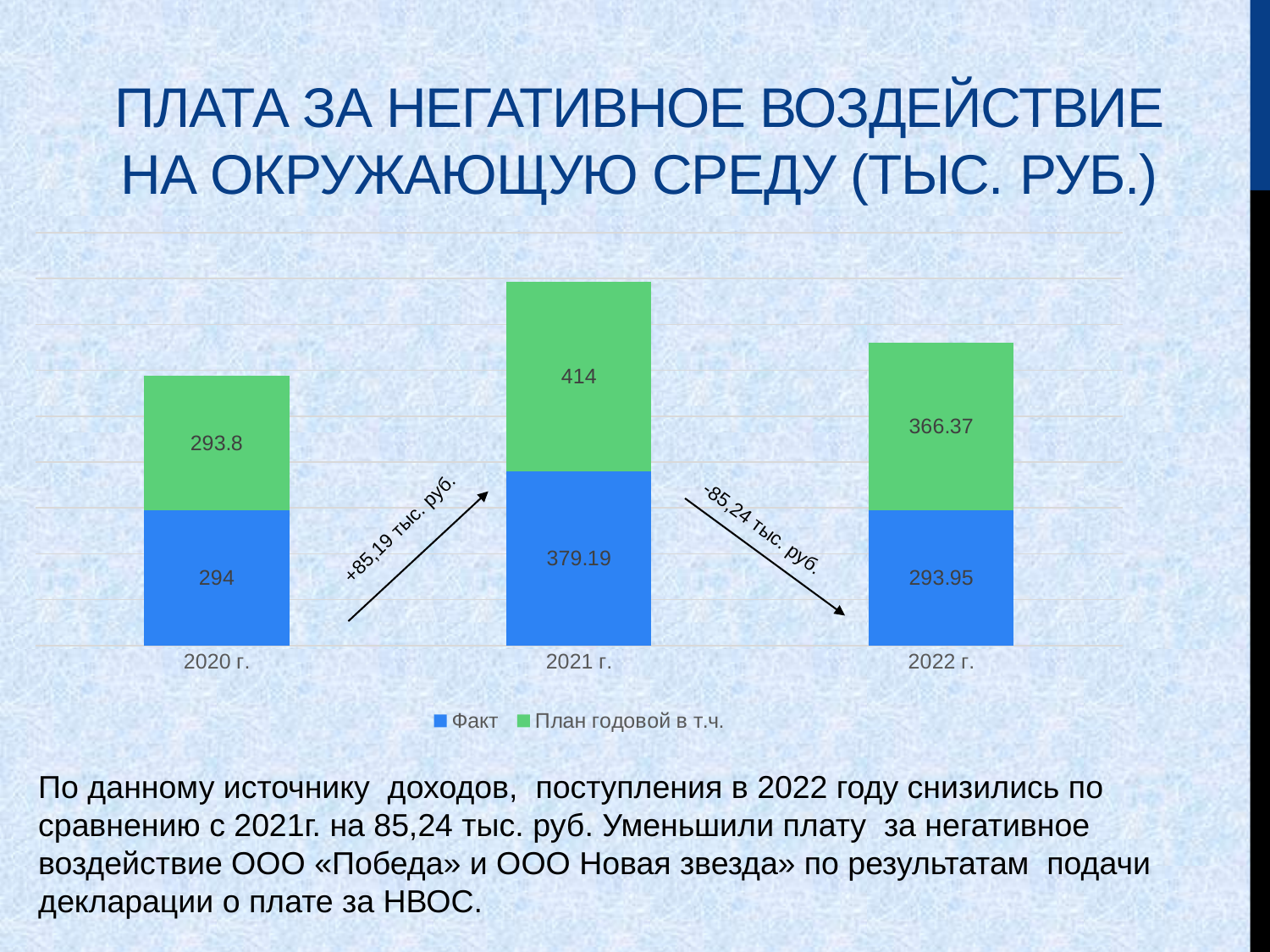
How many years are shown on the x axis? 3 What is the Факт value for 2020 г.? 294 What kind of chart is shown on the slide? Stacked bar chart How many series does the legend list? 2 What is the Факт value for 2021 г.? 379.19 What is the План годовой в т.ч. value for 2022 г.? 366.37 What is the total of the stacked bar for 2021 г.? 793.19 Which year has the highest Факт value? 2021 г. Which is larger: the План годовой в т.ч. value for 2021 г. or for 2022 г.? 2021 г. What is the difference between the Факт values for 2021 г. and 2022 г.? 85.24 Which colour represents the Факт series? Blue Which year has the lowest План годовой в т.ч. value? 2020 г.